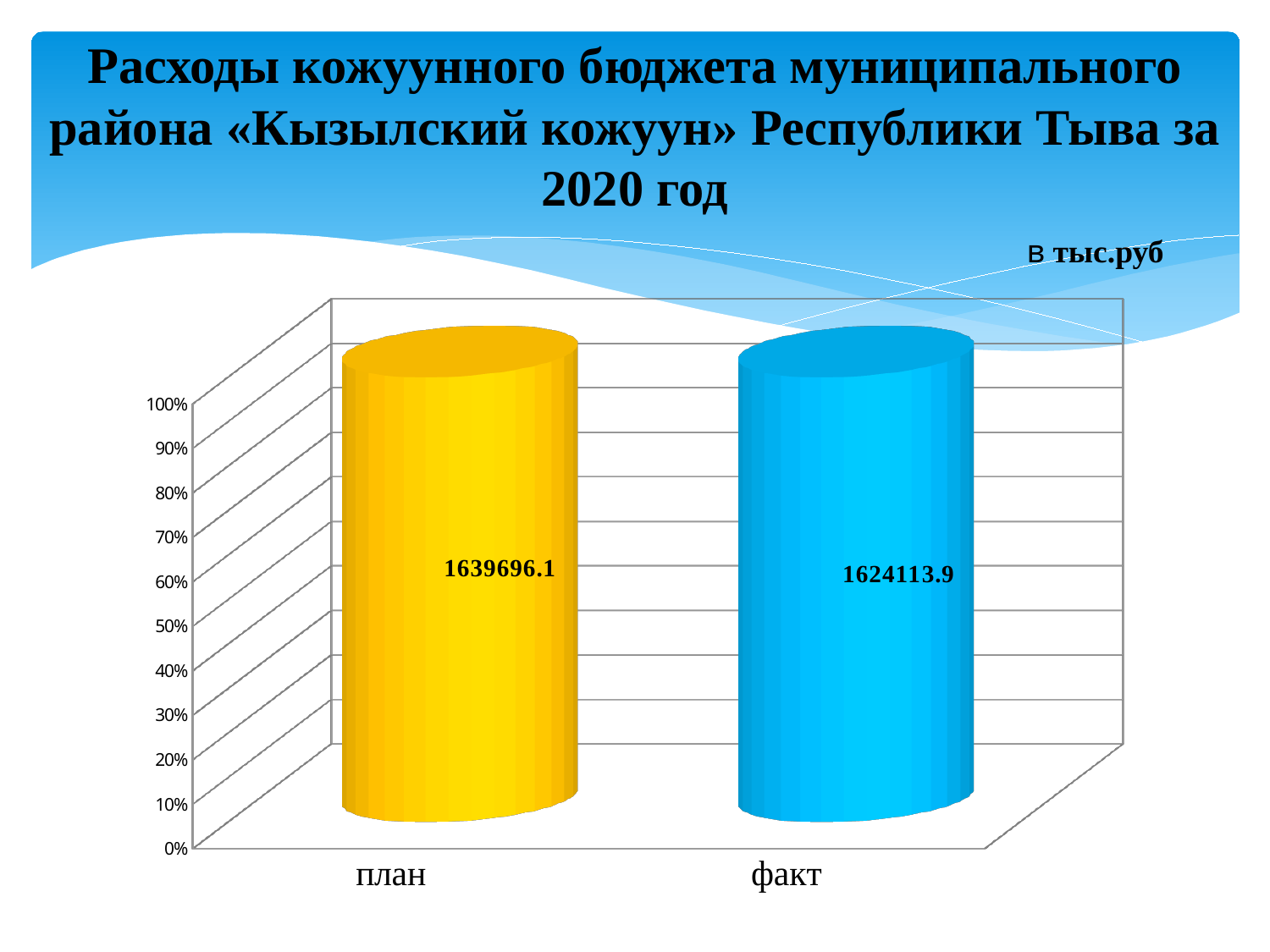
What is the value for план? 1639696.1 Which category has the highest value according to the data labels? план What is the highest tick shown on the vertical axis? 100% What unit is stated for the values on the chart? в тыс.руб How many categories are shown on the x axis? 2 What kind of chart is shown on the slide? bar chart Which is larger according to the data labels, план or факт? план Which category has the lowest value according to the data labels? факт What is the value for факт? 1624113.9 What is the difference between the план and факт values? 15582.2 What colour is the bar for факт? blue